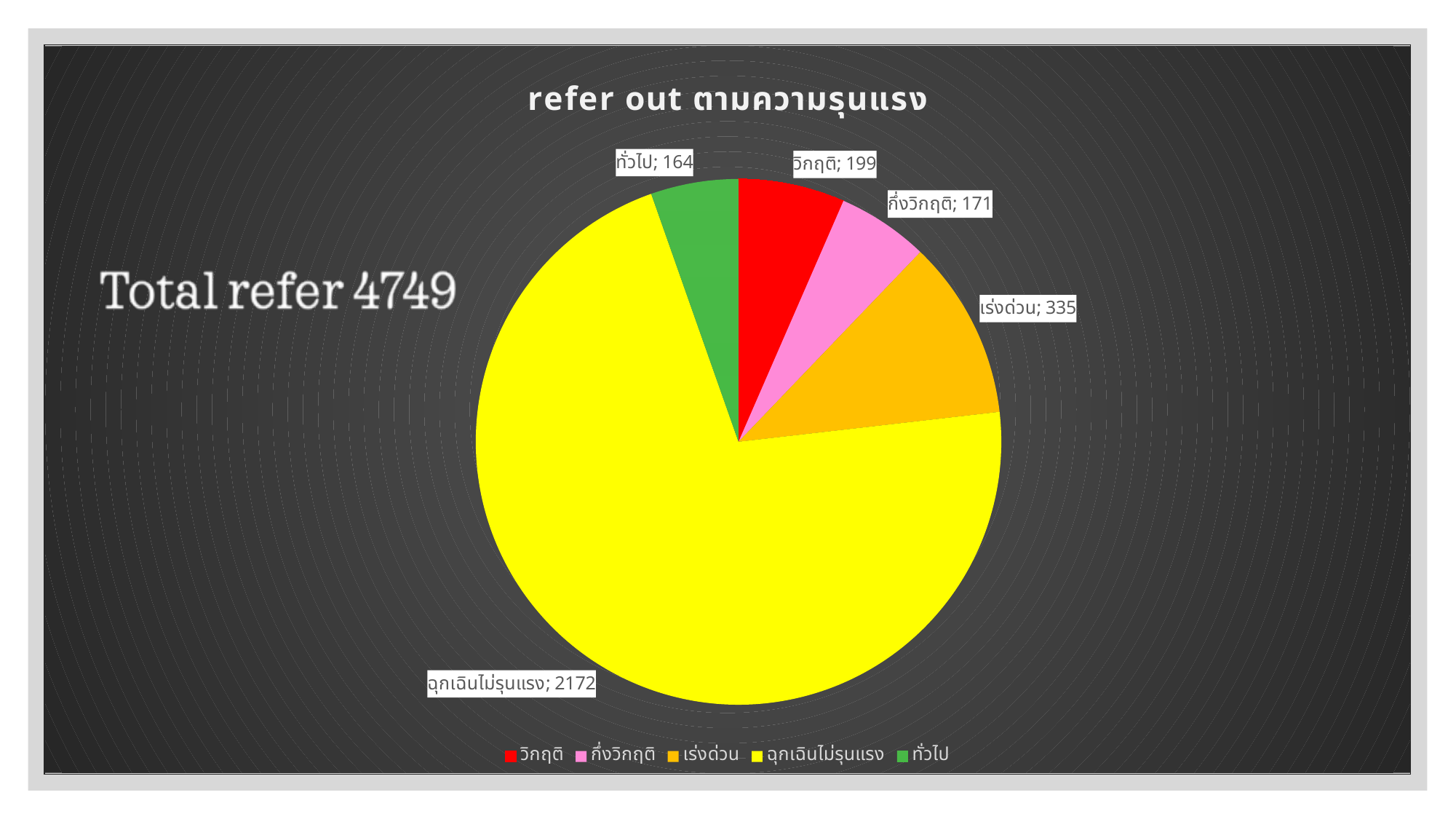
What is the difference between the values for เร่งด่วน and วิกฤติ? 136 What is the title of the chart? refer out ตามความรุนแรง What kind of chart is shown on the slide? pie chart Which category has the largest slice? ฉุกเฉินไม่รุนแรง What is the value for เร่งด่วน? 335 What is the value for วิกฤติ? 199 What is the value for ทั่วไป? 164 Which category has the smallest slice? ทั่วไป Which colour represents เร่งด่วน in the legend? orange What is the value for ฉุกเฉินไม่รุนแรง? 2172 Which is larger, the value for วิกฤติ or the value for กึ่งวิกฤติ? วิกฤติ How many slices does the pie chart have? 5